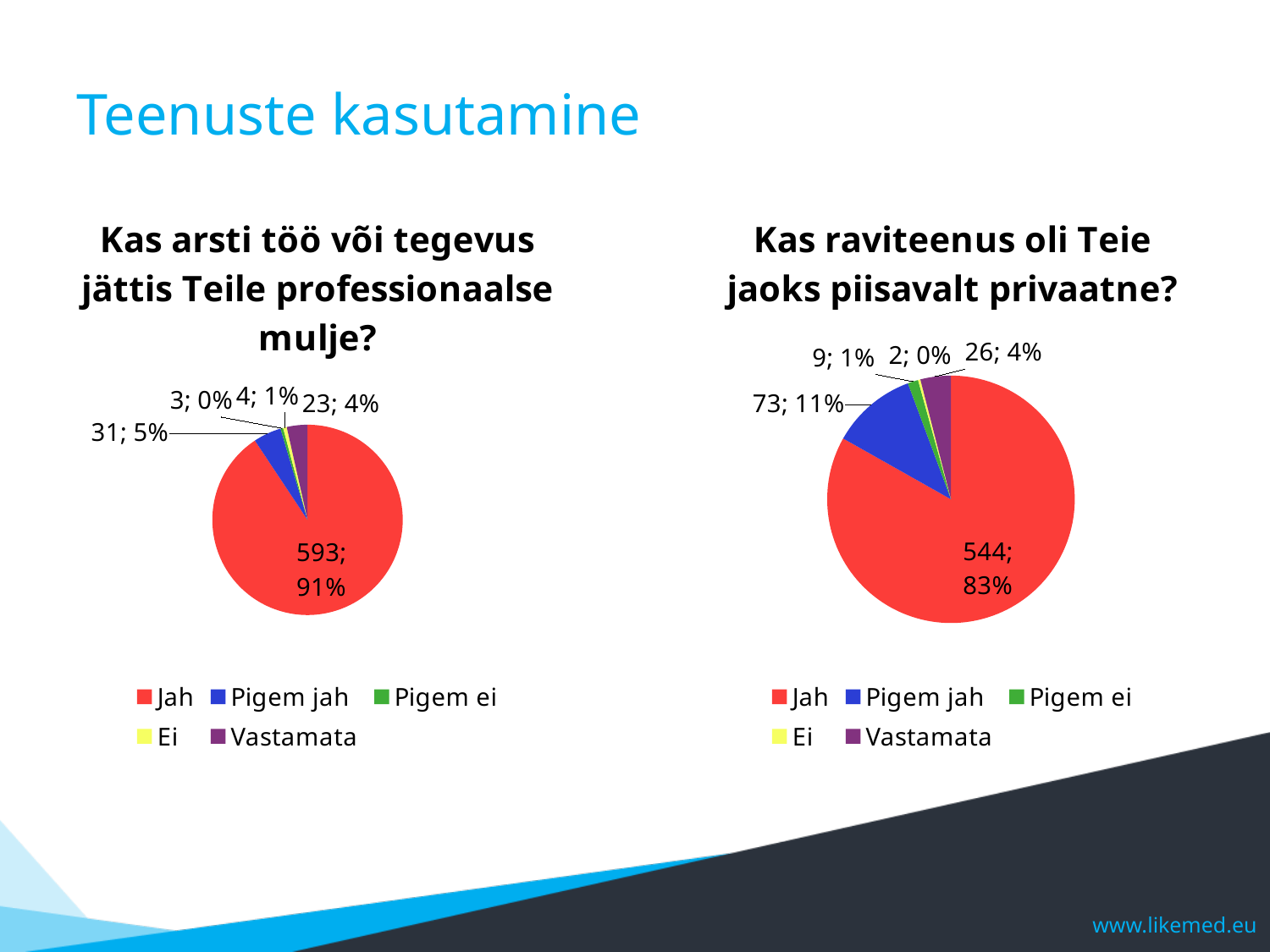
In the right chart ("Kas raviteenus oli Teie jaoks piisavalt privaatne?"), which is larger: Pigem jah or Vastamata? Pigem jah In the left chart ("Kas arsti töö või tegevus jättis Teile professionaalse mulje?"), what is the value for Jah? 593; 91% In the left chart ("Kas arsti töö või tegevus jättis Teile professionaalse mulje?"), what is the value for Pigem jah? 31; 5% In the left chart ("Kas arsti töö või tegevus jättis Teile professionaalse mulje?"), what is the value for Vastamata? 23; 4% In the right chart ("Kas raviteenus oli Teie jaoks piisavalt privaatne?"), what is the value for Pigem jah? 73; 11% What is the difference in count between Jah in the left chart and Jah in the right chart? 49 What type of chart is used on this slide? Pie chart In the right chart ("Kas raviteenus oli Teie jaoks piisavalt privaatne?"), which category has the largest slice? Jah In the right chart ("Kas raviteenus oli Teie jaoks piisavalt privaatne?"), what is the value for Jah? 544; 83% In the left chart ("Kas arsti töö või tegevus jättis Teile professionaalse mulje?"), which category has the smallest count? Pigem ei How many categories does the legend of the left chart list? 5 In the right chart ("Kas raviteenus oli Teie jaoks piisavalt privaatne?"), what is the value for Pigem ei? 9; 1%